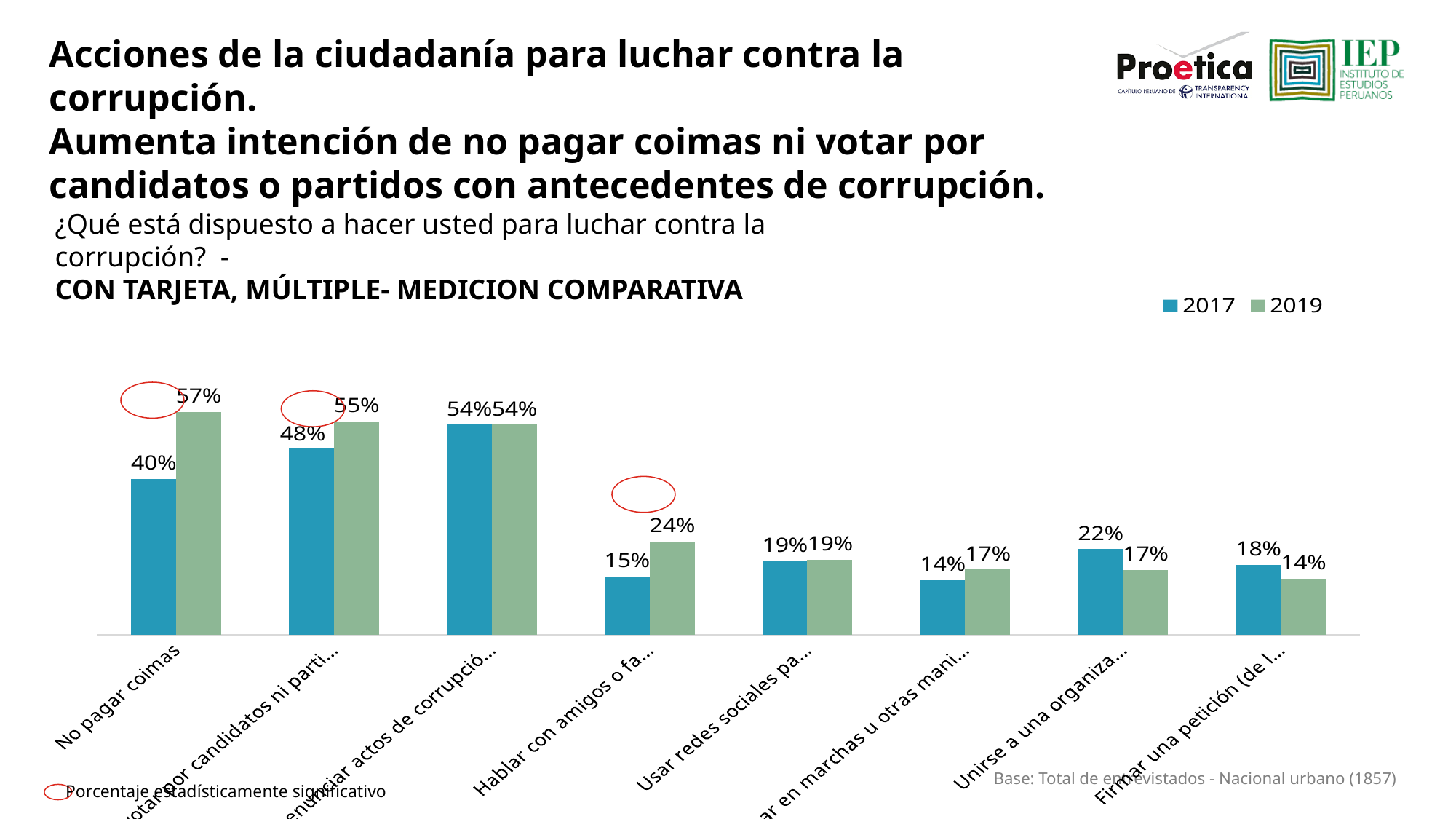
How many series does the legend list? 2 What is the 2019 value for the category beginning "Hablar con amigos"? 24% What is the 2017 value for "No pagar coimas"? 40% What kind of chart is shown on the slide? Bar chart How many categories are shown on the x axis of the chart? 8 What is the 2017 value for the category beginning "Unirse a una organiza"? 22% What is the difference between the 2019 and 2017 values for "No pagar coimas"? 17 percentage points For the category beginning "Unirse a una organiza", which year has the larger value, 2017 or 2019? 2017 Which category has the highest 2019 value? No pagar coimas What is the 2019 value for "No pagar coimas"? 57% For the category beginning "Hablar con amigos", which year has the larger value, 2017 or 2019? 2019 What is the 2019 value for the category beginning "Firmar una petición"? 14%